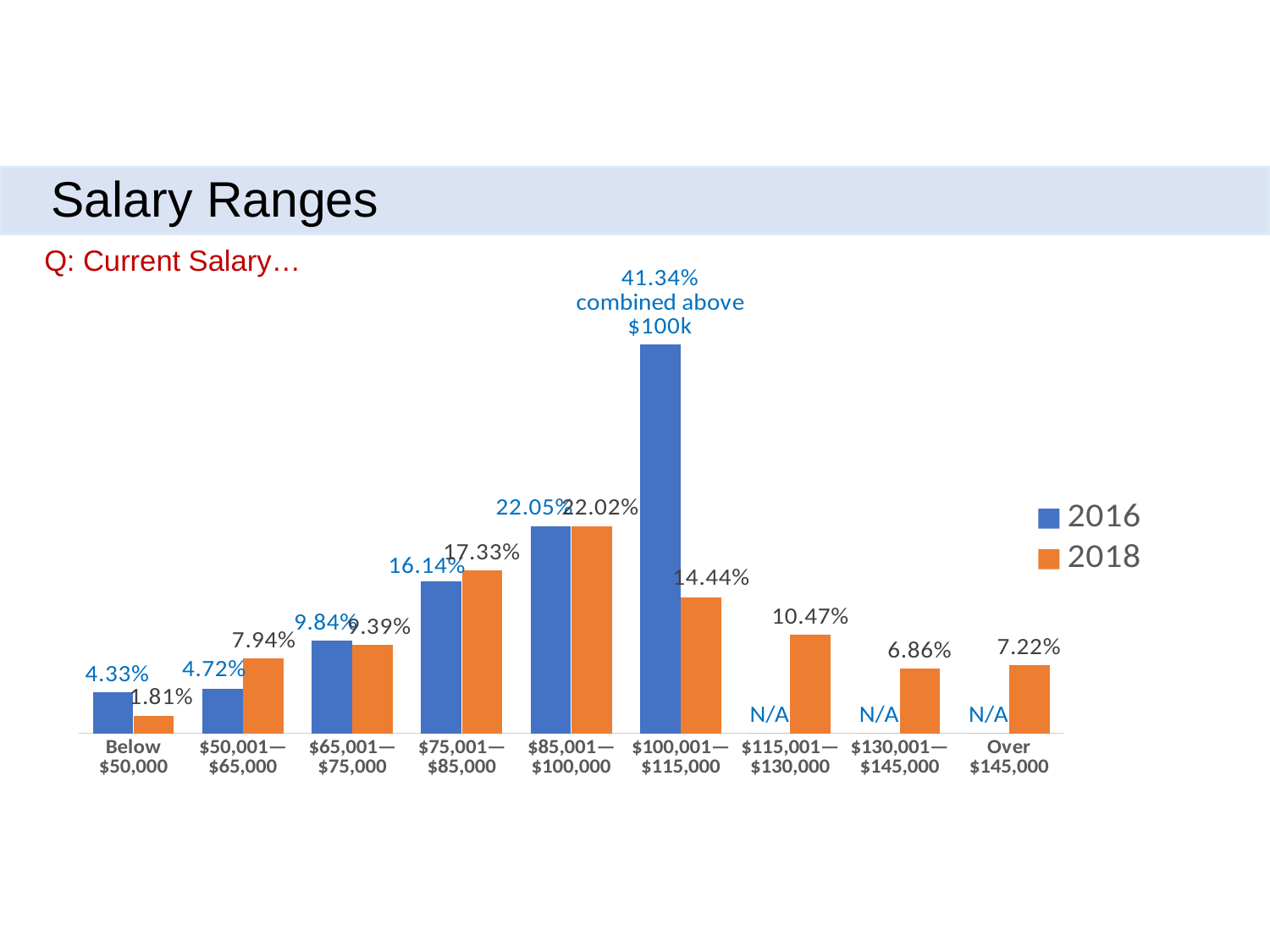
What is the 2016 value for the Below $50,000 salary range? 4.33% Which salary range has the highest 2018 value? $85,001—$100,000 For the $100,001—$115,000 range, which series has the larger value, 2016 or 2018? 2016 How many salary range categories are shown on the x axis? 9 What is the 2018 value for the Over $145,000 salary range? 7.22% What kind of chart is shown on the slide? Bar chart How many series does the legend list? 2 What is the difference between the 2018 and 2016 values for the $50,001—$65,000 range? 3.22% What is the 2018 value for the $100,001—$115,000 salary range? 14.44% What is the difference between the 2018 values for $100,001—$115,000 and Below $50,000? 12.63% Which salary range has the lowest 2018 value? Below $50,000 What is the 2016 value shown for the $115,001—$130,000 salary range? N/A